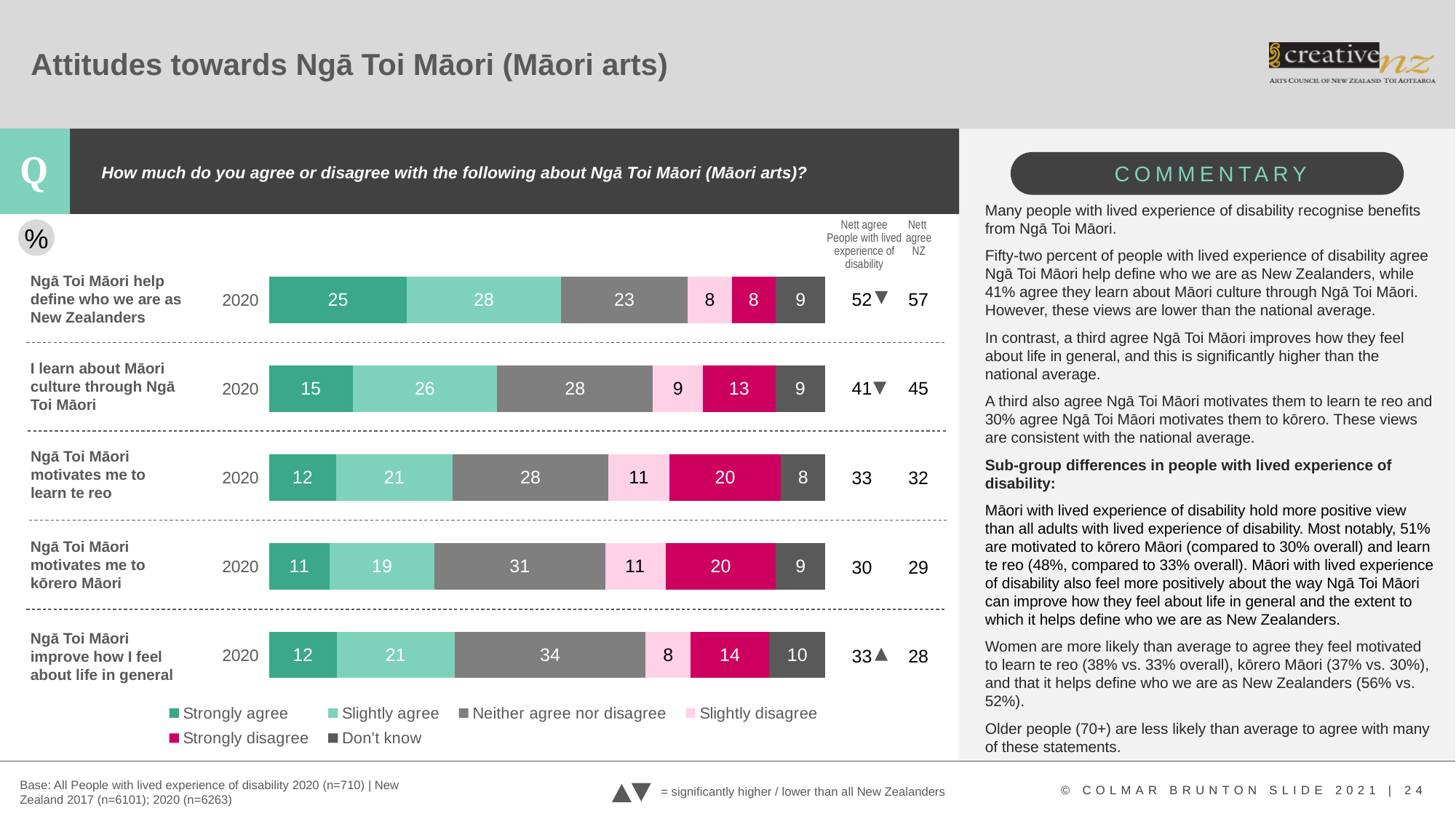
What is the combined 'Strongly agree' and 'Slightly agree' total for 'Ngā Toi Māori motivates me to learn te reo'? 33 What kind of chart is shown on the slide? Stacked bar chart What is the 'Strongly disagree' value for 'I learn about Māori culture through Ngā Toi Māori'? 13 What is the 'Neither agree nor disagree' value for the statement 'Ngā Toi Māori improve how I feel about life in general'? 34 Which statement has the lowest 'Strongly agree' value? Ngā Toi Māori motivates me to kōrero Māori What is the difference between the 'Slightly agree' values for 'Ngā Toi Māori help define who we are as New Zealanders' and 'Ngā Toi Māori motivates me to kōrero Māori'? 9 What colour represents 'Strongly disagree' in the legend? Magenta/pink-red Is the 'Strongly disagree' value larger for 'Ngā Toi Māori motivates me to learn te reo' or for 'Ngā Toi Māori improve how I feel about life in general'? Ngā Toi Māori motivates me to learn te reo Which statement has the highest 'Strongly agree' value? Ngā Toi Māori help define who we are as New Zealanders How many statements are shown in the chart? 5 What percentage of people strongly agree that Ngā Toi Māori help define who we are as New Zealanders? 25 How many series does the legend list? 6